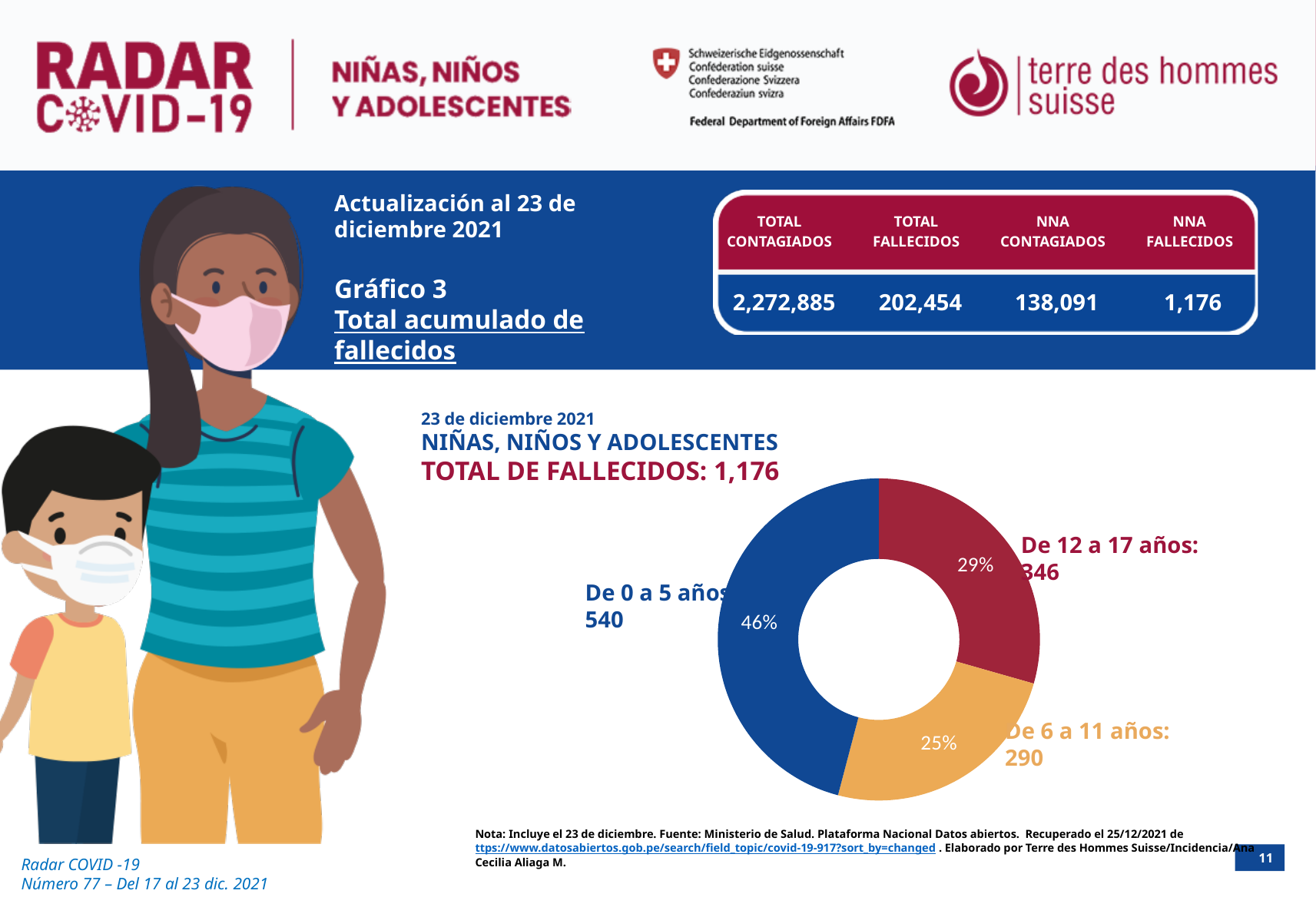
Which age group has the lowest number of deaths? De 6 a 11 años What percentage of the chart does 'De 6 a 11 años' represent? 25% What percentage of the chart does 'De 12 a 17 años' represent? 29% What is the number of deaths for 'De 6 a 11 años'? 290 What total number of deaths is stated in the chart title? 1,176 What is the number of deaths for 'De 0 a 5 años'? 540 What is the difference in deaths between 'De 0 a 5 años' and 'De 6 a 11 años'? 250 How many age groups are shown in the chart? 3 What kind of chart is shown on the slide? donut chart What percentage of the chart does 'De 0 a 5 años' represent? 46% Which has more deaths, 'De 12 a 17 años' or 'De 6 a 11 años'? De 12 a 17 años Which age group has the highest number of deaths? De 0 a 5 años